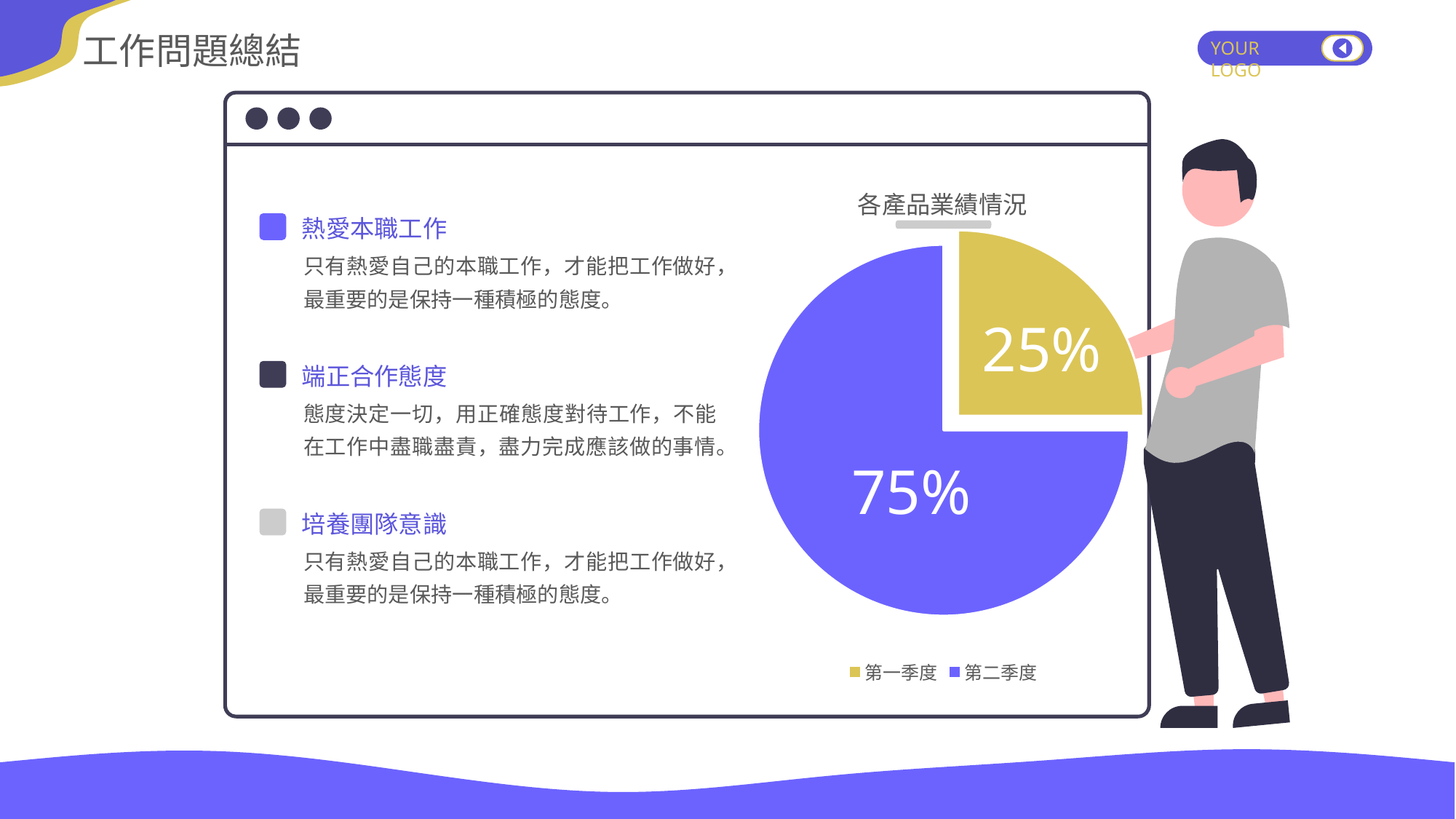
What share of the pie does 第二季度 have? 75% How many slices does the pie chart have? 2 What is the difference in percentage points between the 第二季度 and 第一季度 slices? 50 How many entries does the legend list? 2 What kind of chart is shown on the slide? pie chart What colour is the 第一季度 slice in the pie chart? yellow What is the title of the pie chart? 各產品業績情況 Which category has the largest slice of the pie? 第二季度 What share of the pie does 第一季度 have? 25% Which category has the smallest slice of the pie? 第一季度 Which is larger, the slice for 第一季度 or the slice for 第二季度? 第二季度